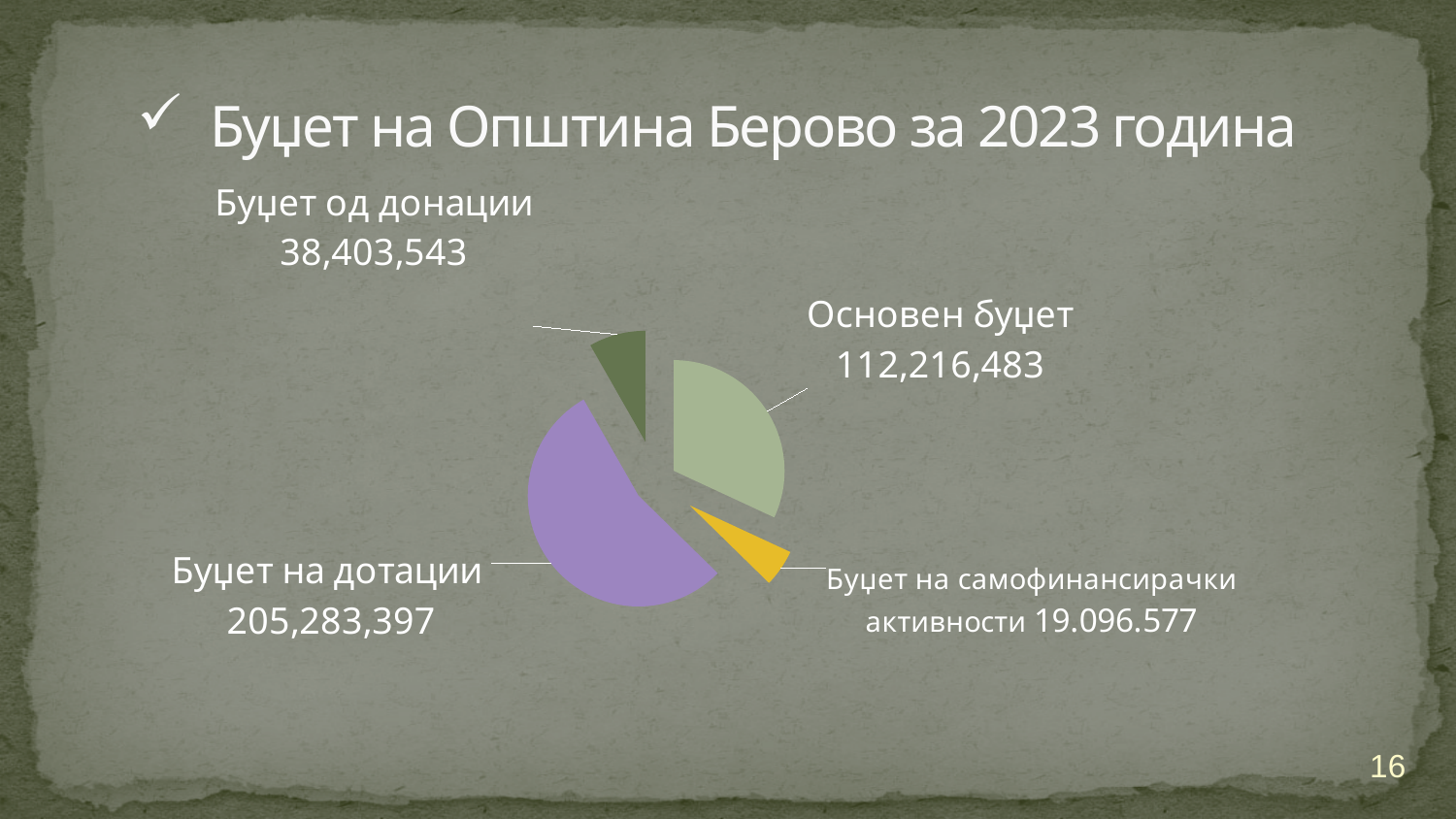
How many slices does the pie chart have? 4 Which category has the largest slice of the pie? Буџет на дотации What is the value for Основен буџет? 112,216,483 What kind of chart is shown on the slide? pie chart What is the difference between Буџет на дотации and Основен буџет? 93,066,914 What is the value for Буџет на дотации? 205,283,397 Which is larger, Основен буџет or Буџет од донации? Основен буџет What is the title of the slide containing the pie chart? Буџет на Општина Берово за 2023 година Which category has the smallest slice of the pie? Буџет на самофинансирачки активности What is the value for Буџет од донации? 38,403,543 What is the value for Буџет на самофинансирачки активности? 19.096.577 What is the difference between Основен буџет and Буџет од донации? 73,812,940